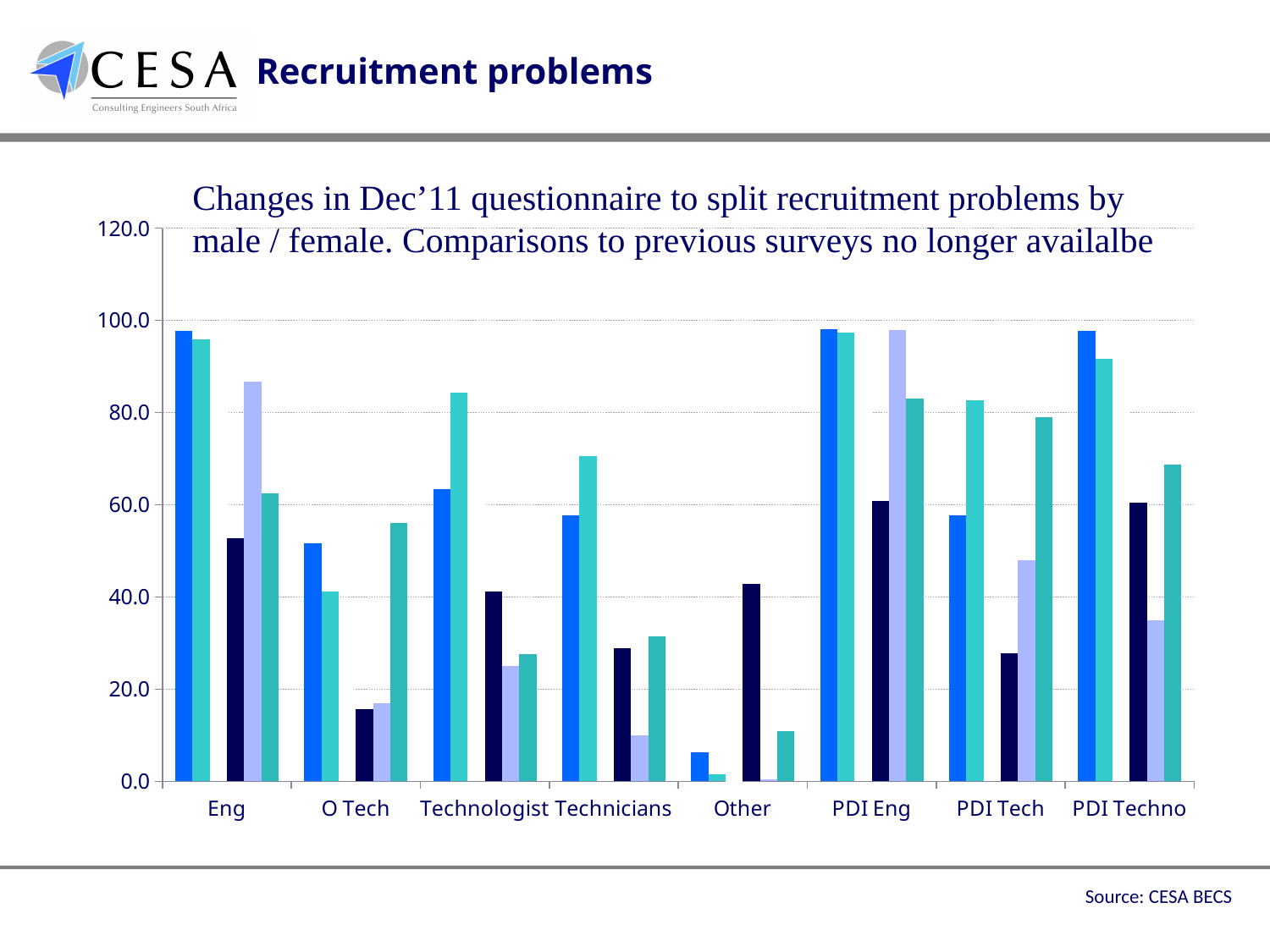
Which category contains the lowest bar on the chart? Other What is the maximum value shown on the y axis of the chart? 120.0 Which category has a taller tallest bar, Eng or Other? Eng Is the tallest bar for Eng greater or less than 80? greater Is the shortest bar for Technicians greater or less than 20? less What source is cited for the chart on the slide? CESA BECS What kind of chart is shown on the slide? bar chart Is the shortest bar for PDI Eng greater or less than 40? greater How many bars are plotted for each category on the chart? 5 Which category has a taller tallest bar, PDI Eng or O Tech? PDI Eng How many categories are shown along the x axis of the chart? 8